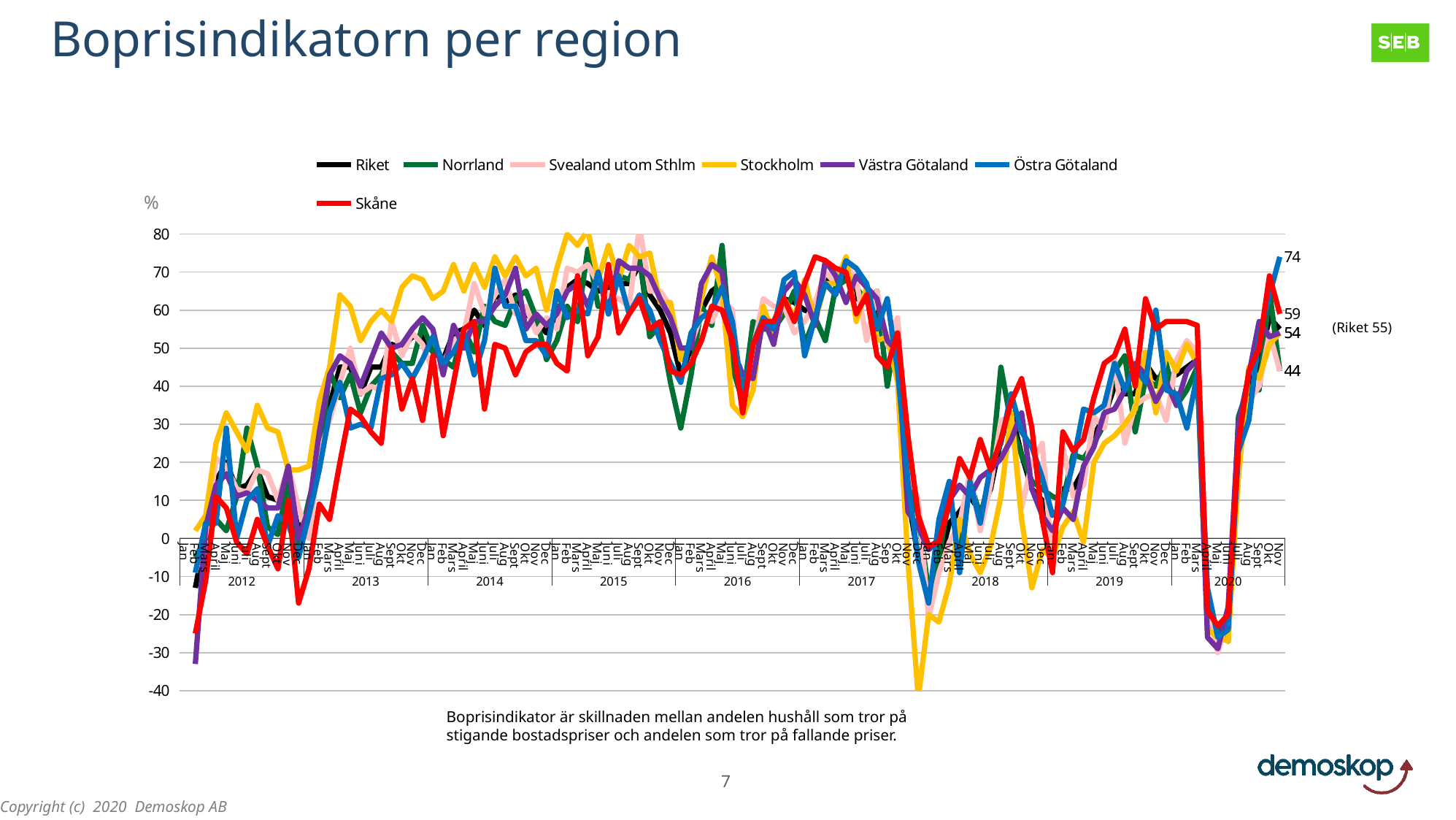
How many series does the legend list? 7 What is the latest value for Riket given in the annotation next to the chart? 55 What unit is shown on the y axis? % What kind of chart is shown on the slide? line chart What is the title of the chart? Boprisindikatorn per region Which is larger: the latest Östra Götaland value (74) or the latest Riket value (55)? Östra Götaland (74) What is the lowest value labelled at the right end of the chart? 44 Which series ends highest at the right edge of the chart? Östra Götaland What is the difference between the highest end label (74) and the lowest end label (44)? 30 What is the highest value labelled at the right end of the chart? 74 Is the latest Riket value greater or less than 50? greater What is the difference between the end labels 74 and 59? 15